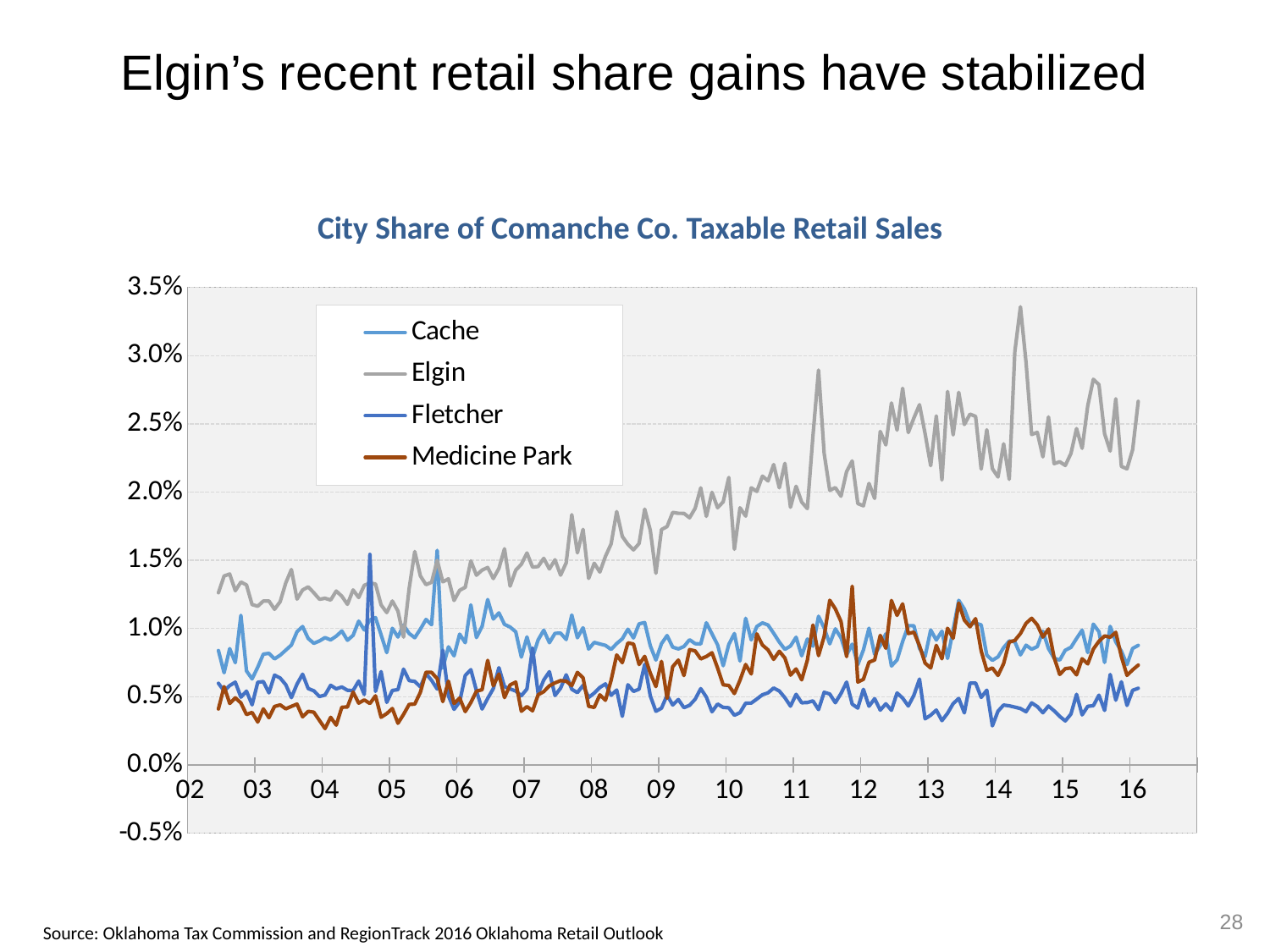
What kind of chart is shown on the slide? line chart What is the title of the chart? City Share of Comanche Co. Taxable Retail Sales How many series does the legend list? 4 Which series reaches the highest value anywhere on the chart? Elgin Which series has the lowest values around 2015? Fletcher Is the peak value for Elgin around 2014 greater or less than 3.0%? greater Does the Elgin series rise or fall from 2002 to 2016? rise Which series is drawn in gray? Elgin Is the value for Elgin at the start of the series in 2002 greater or less than 2.0%? less Is the value for Fletcher at the end of the series in 2016 greater or less than 1.0%? less Around 2015, which series has the larger values, Elgin or Fletcher? Elgin How many year labels are shown on the x axis? 15